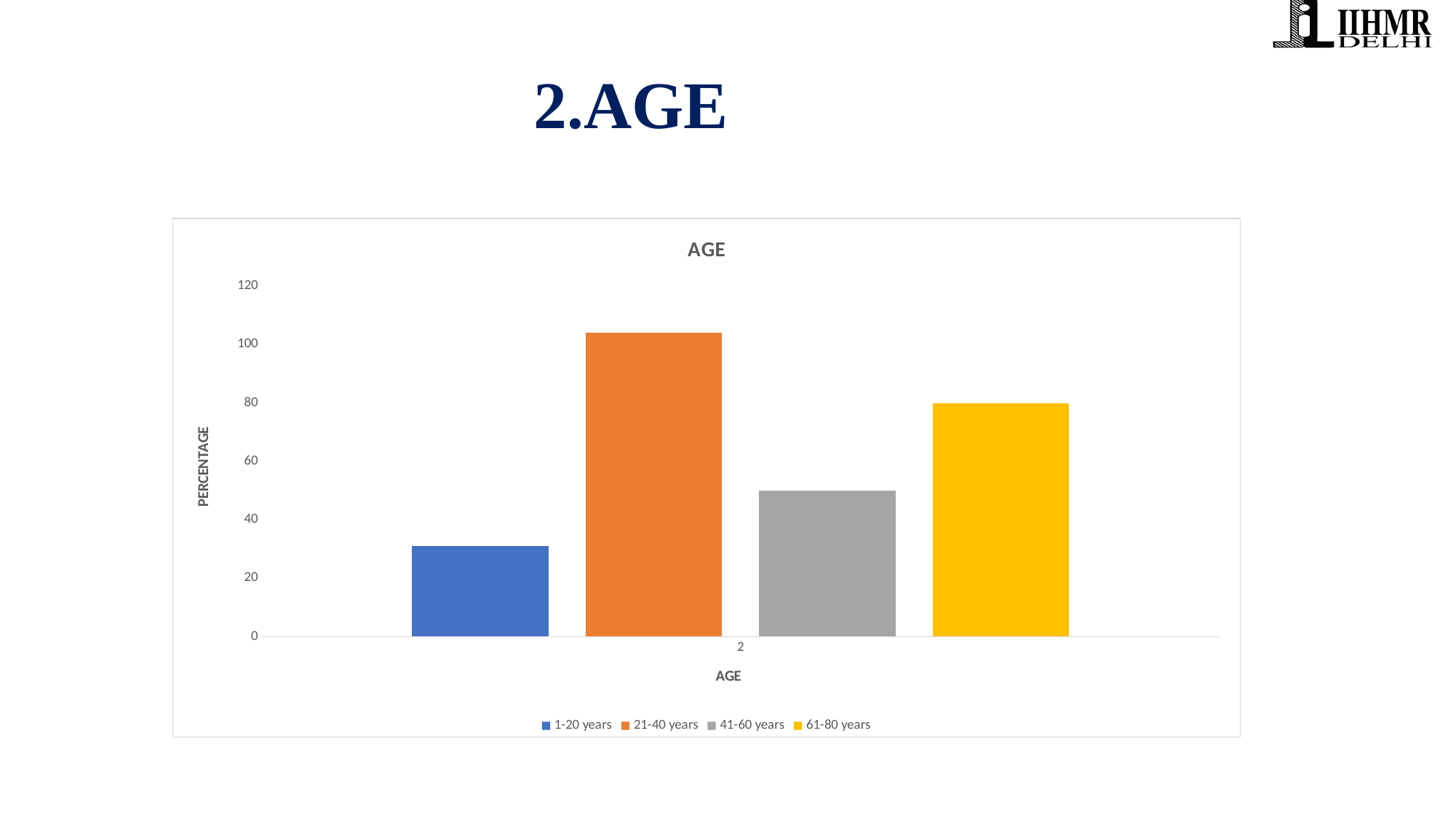
What kind of chart is shown on the slide? bar chart Is the value for 41-60 years greater or less than 60? less Which is larger, the value for 1-20 years or the value for 41-60 years? 41-60 years Which age group has the lowest bar? 1-20 years Is the value for 1-20 years greater or less than 40? less Which is larger, the value for 61-80 years or the value for 41-60 years? 61-80 years What is the title of the chart? AGE Is the value for 61-80 years greater or less than 100? less What is the label on the vertical axis of the chart? PERCENTAGE How many series does the chart's legend list? 4 Which age group has the highest bar? 21-40 years